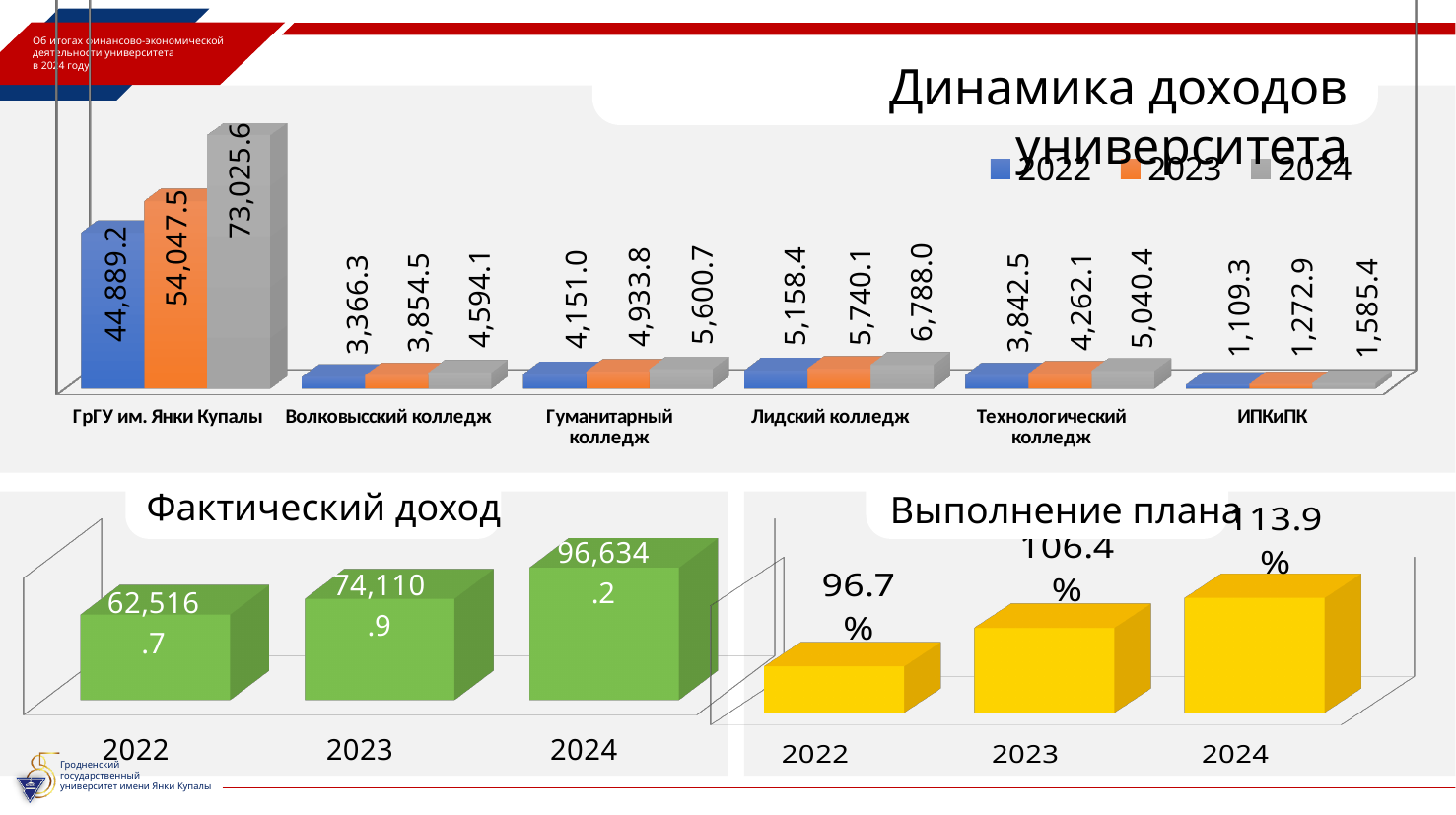
In the 'Динамика доходов университета' chart, which is larger: the 2024 value for Гуманитарный колледж or the 2024 value for Волковысский колледж? Гуманитарный колледж In the 'Динамика доходов университета' chart, what is the difference between the 2024 and 2023 values for Технологический колледж? 778.3 In the 'Динамика доходов университета' chart, what is the 2024 value for ГрГУ им. Янки Купалы? 73,025.6 In the 'Фактический доход' chart, what is the difference between the 2023 and 2022 values? 11,594.2 In the 'Динамика доходов университета' chart, which category has the lowest 2023 value? ИПКиПК In the 'Динамика доходов университета' chart, how many series does the legend list? 3 In the 'Динамика доходов университета' chart, what is the 2022 value for Лидский колледж? 5,158.4 In the 'Выполнение плана' chart, what is the value for 2023? 106.4% What kind of chart is the 'Выполнение плана' chart? bar chart In the 'Фактический доход' chart, do the values rise or fall from 2022 to 2024? rise In the 'Динамика доходов университета' chart, how many categories are shown on the x axis? 6 In the 'Фактический доход' chart, what is the value for 2024? 96,634.2